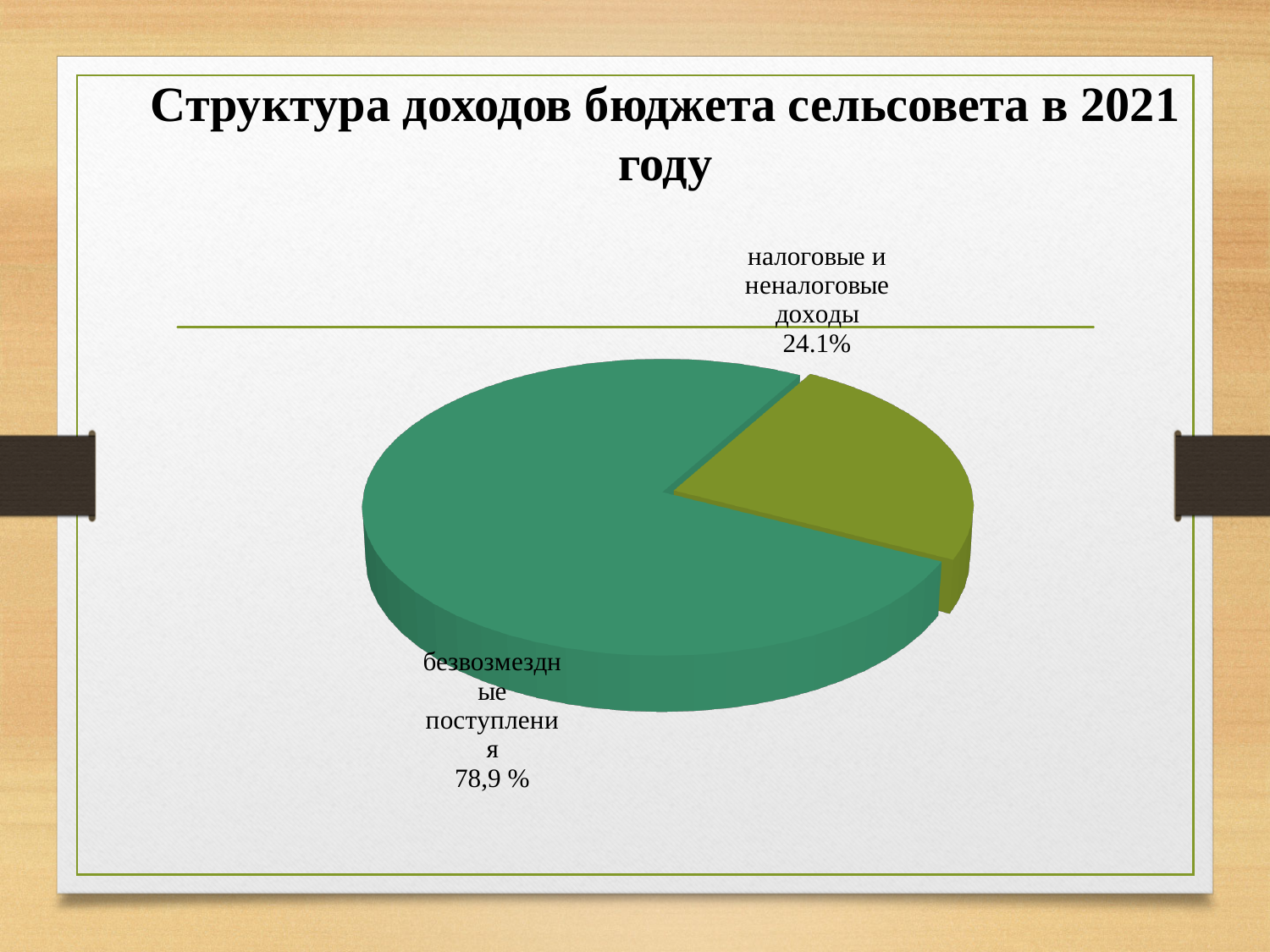
What share of the pie is labelled for "безвозмездные поступления"? 78,9 % Which is larger: the slice for "безвозмездные поступления" or the slice for "налоговые и неналоговые доходы"? безвозмездные поступления What value is printed for the slice "налоговые и неналоговые доходы"? 24.1% What colour is the slice for "налоговые и неналоговые доходы"? olive green What is the title of the chart on the slide? Структура доходов бюджета сельсовета в 2021 году What value is printed for the slice "безвозмездные поступления"? 78,9 % What share of the pie is labelled for "налоговые и неналоговые доходы"? 24.1% How many slices does the pie chart have? 2 What kind of chart is shown on the slide? pie chart Which slice of the pie chart is the largest? безвозмездные поступления Which slice of the pie chart is the smallest? налоговые и неналоговые доходы